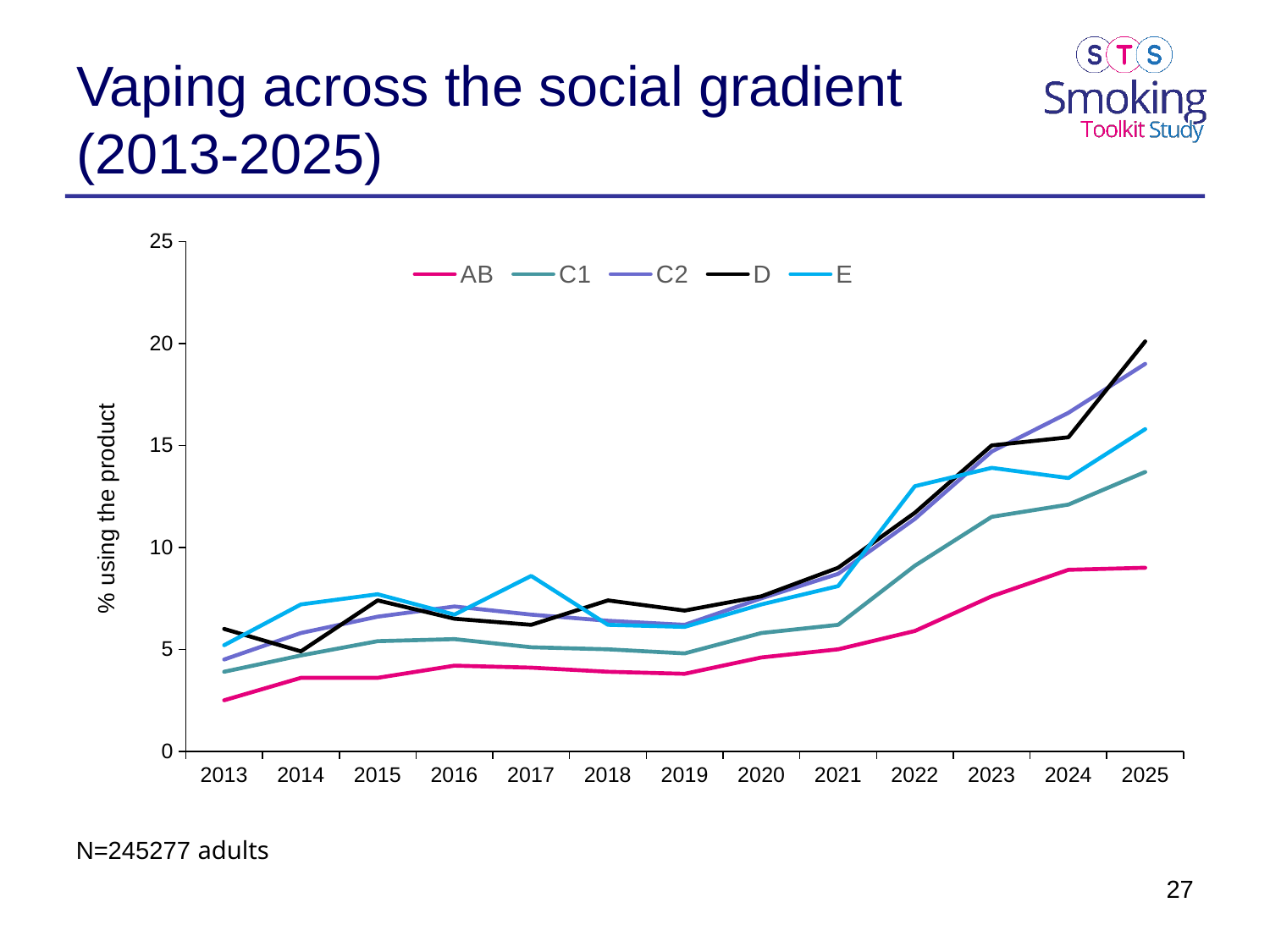
Is the value for AB in 2013 greater or less than 5? less Which series has the lowest value in 2025? AB What is the label on the y axis? % using the product Which series has the lowest value in 2013? AB How many years are shown on the x axis? 13 Is the value for E in 2022 greater or less than 10? greater Which series has the highest value in 2025? D What kind of chart is shown on the slide? line chart Which is larger in 2022, the value for E or the value for C1? E How many series does the legend list? 5 Is the value for AB in 2025 greater or less than 10? less Does the value for AB rise or fall from 2013 to 2025? rise